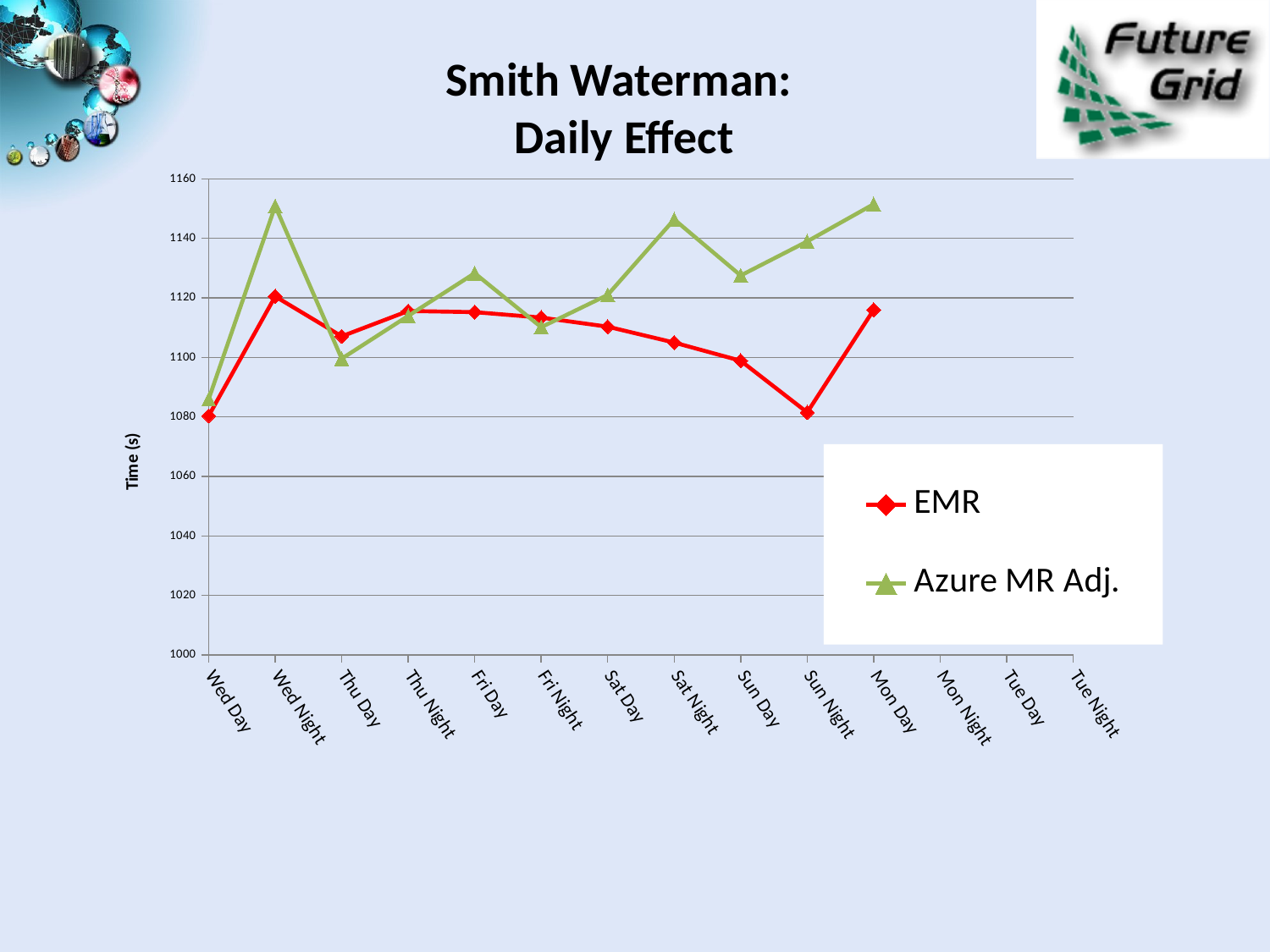
Is the EMR value for Sun Night greater or less than 1100? less Is the Azure MR Adj. value for Fri Day greater or less than 1120? greater What are the two series named in the legend? EMR and Azure MR Adj. What is the label of the vertical axis? Time (s) How many series does the legend list? 2 At Sun Night, which series has the higher value, EMR or Azure MR Adj.? Azure MR Adj. How many data points are plotted for the EMR series? 11 Is the EMR value for Thu Day greater or less than 1100? greater At Wed Night, which series has the higher value, EMR or Azure MR Adj.? Azure MR Adj. Does the EMR series rise or fall from Thu Night to Sun Night? fall What kind of chart is shown on the slide? line chart